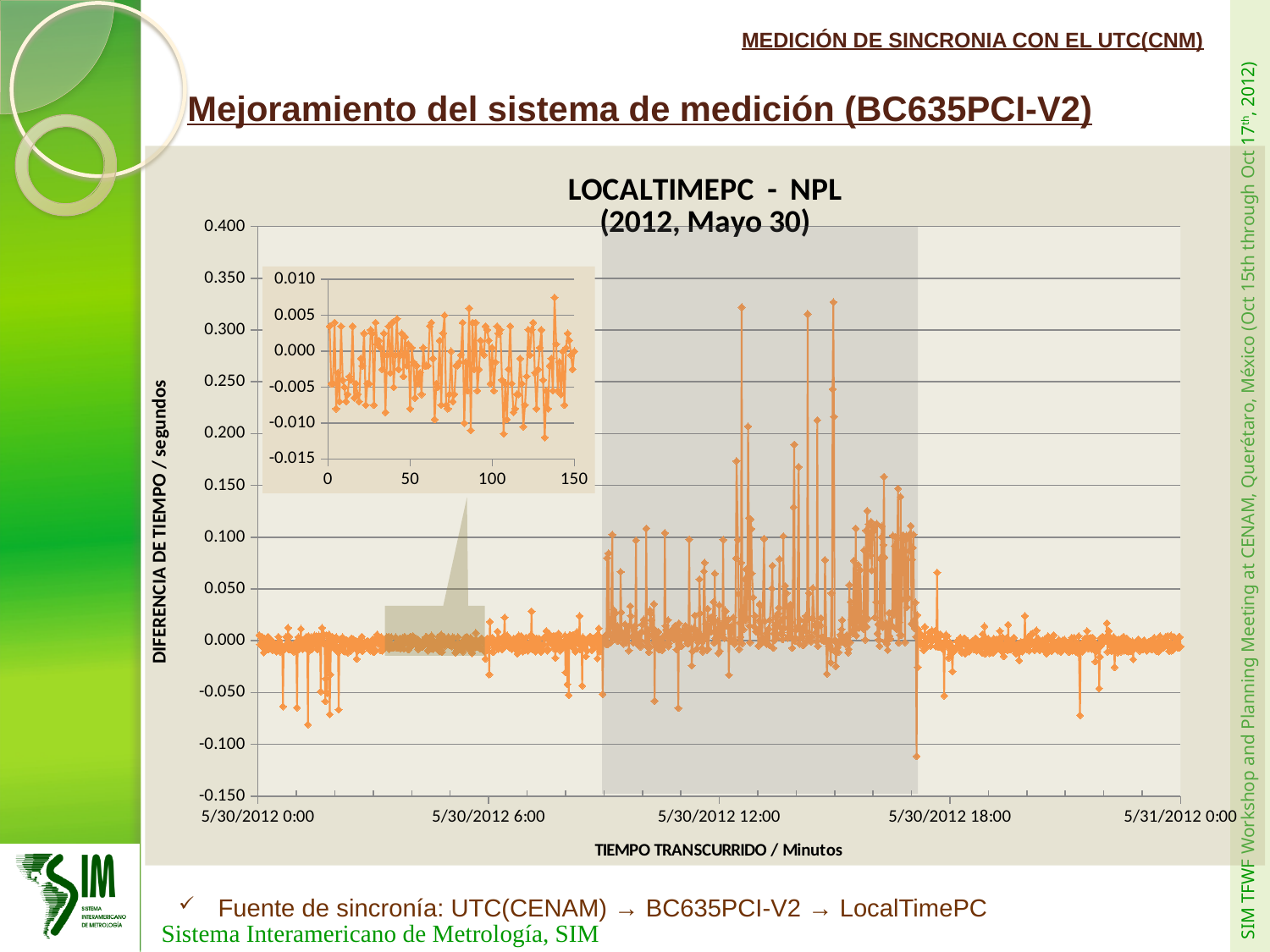
In the inset chart, is the lowest point greater or less than -0.010? less In the main chart, is the lowest point in the data greater or less than -0.050? less What kind of chart is shown on the slide? line chart In the main chart, are the fluctuations larger between 5/30/2012 12:00 and 5/30/2012 18:00 or between 5/30/2012 0:00 and 5/30/2012 6:00? between 5/30/2012 12:00 and 5/30/2012 18:00 In the inset chart, is the highest point greater or less than 0.010? less What is the label of the vertical axis of the main chart? DIFERENCIA DE TIEMPO / segundos What is the title of the main chart? LOCALTIMEPC - NPL (2012, Mayo 30) In the main chart, do the values after 5/30/2012 18:00 stay mostly near 0.000 or rise steadily toward 5/31/2012 0:00? stay mostly near 0.000